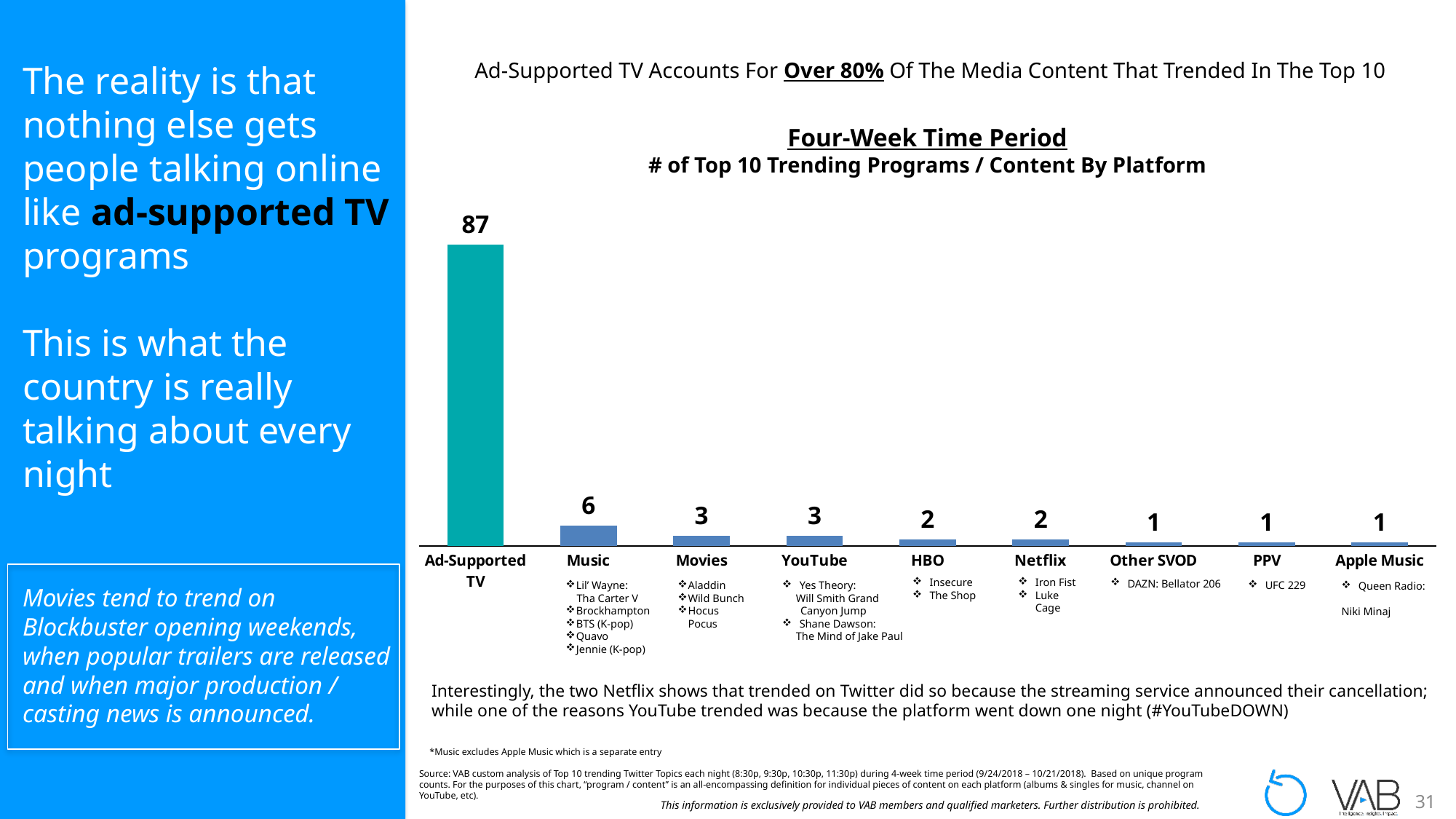
What kind of chart is shown? Bar chart Which is larger, the value for HBO or the value for Music? Music Do the values rise or fall from left to right along the x axis? Fall What is the value for Netflix? 2 What is the value for Music? 6 What is the difference between the values for Music and Movies? 3 What is the value for Ad-Supported TV? 87 How many platforms are shown on the x axis? 9 What is the subtitle of the chart below 'Four-Week Time Period'? # of Top 10 Trending Programs / Content By Platform What is the difference between the values for Ad-Supported TV and Music? 81 What is the value for YouTube? 3 Which platform has the highest number of Top 10 trending programs? Ad-Supported TV